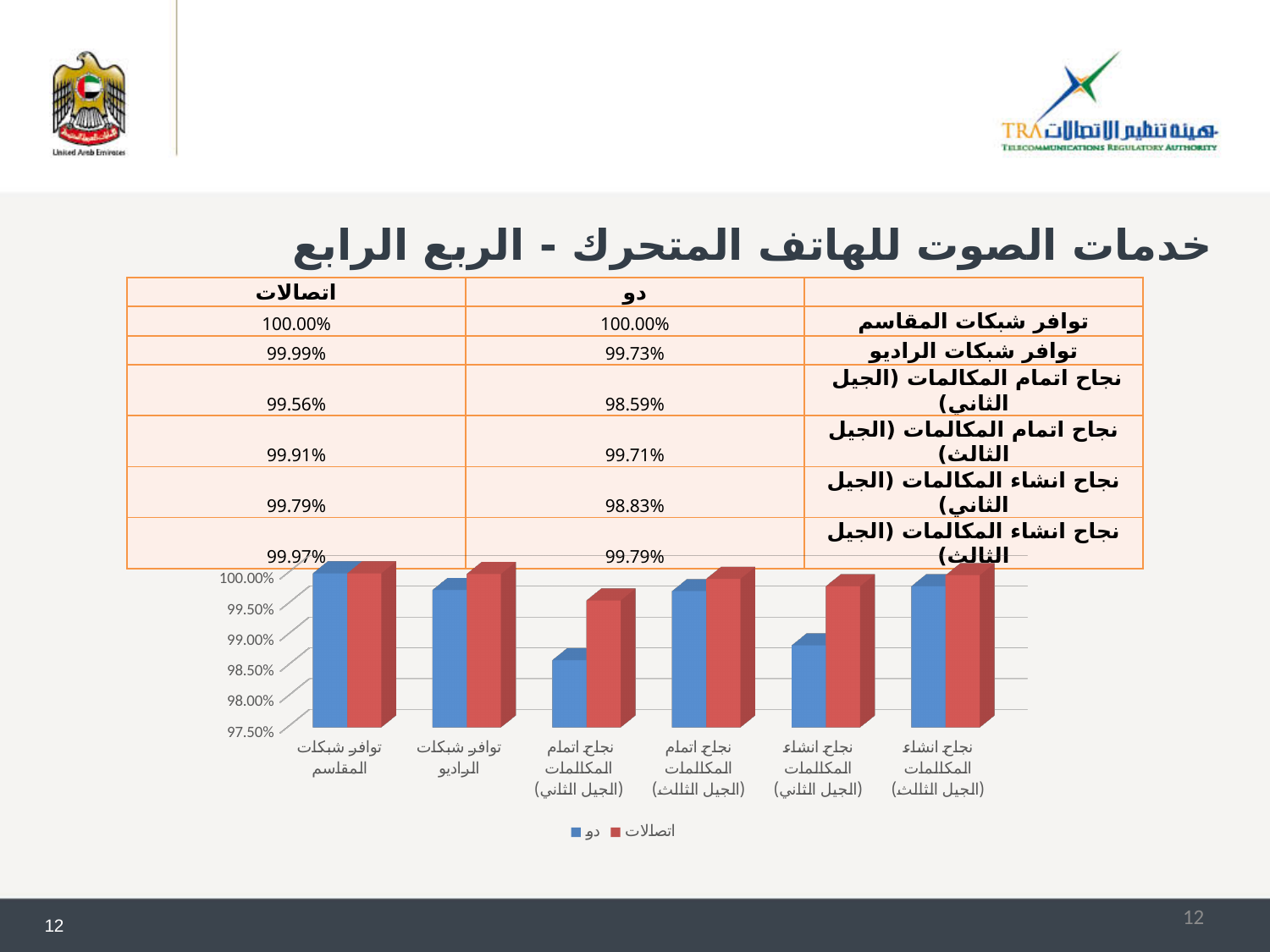
Is the value for دو in the category نجاح انشاء المكالمات (الجيل الثاني) greater or less than 99.00%? less How many series does the chart legend list? 2 In the category نجاح انشاء المكالمات (الجيل الثاني), which series has the larger value, اتصالات or دو? اتصالات What is the value for دو in the category توافر شبكات المقاسم? 100.00% Which category has the lowest value for دو? نجاح اتمام المكالمات (الجيل الثاني) What is the difference between the اتصالات and دو values for نجاح اتمام المكالمات (الجيل الثاني)? 0.97% What is the value for دو in the category نجاح اتمام المكالمات (الجيل الثاني)? 98.59% What kind of chart is shown on the slide? bar chart What are the two series names listed in the chart legend? اتصالات and دو What is the value for اتصالات in the category توافر شبكات الراديو? 99.99% How many categories are shown on the x axis of the chart? 6 What colour are the bars for the دو series? blue